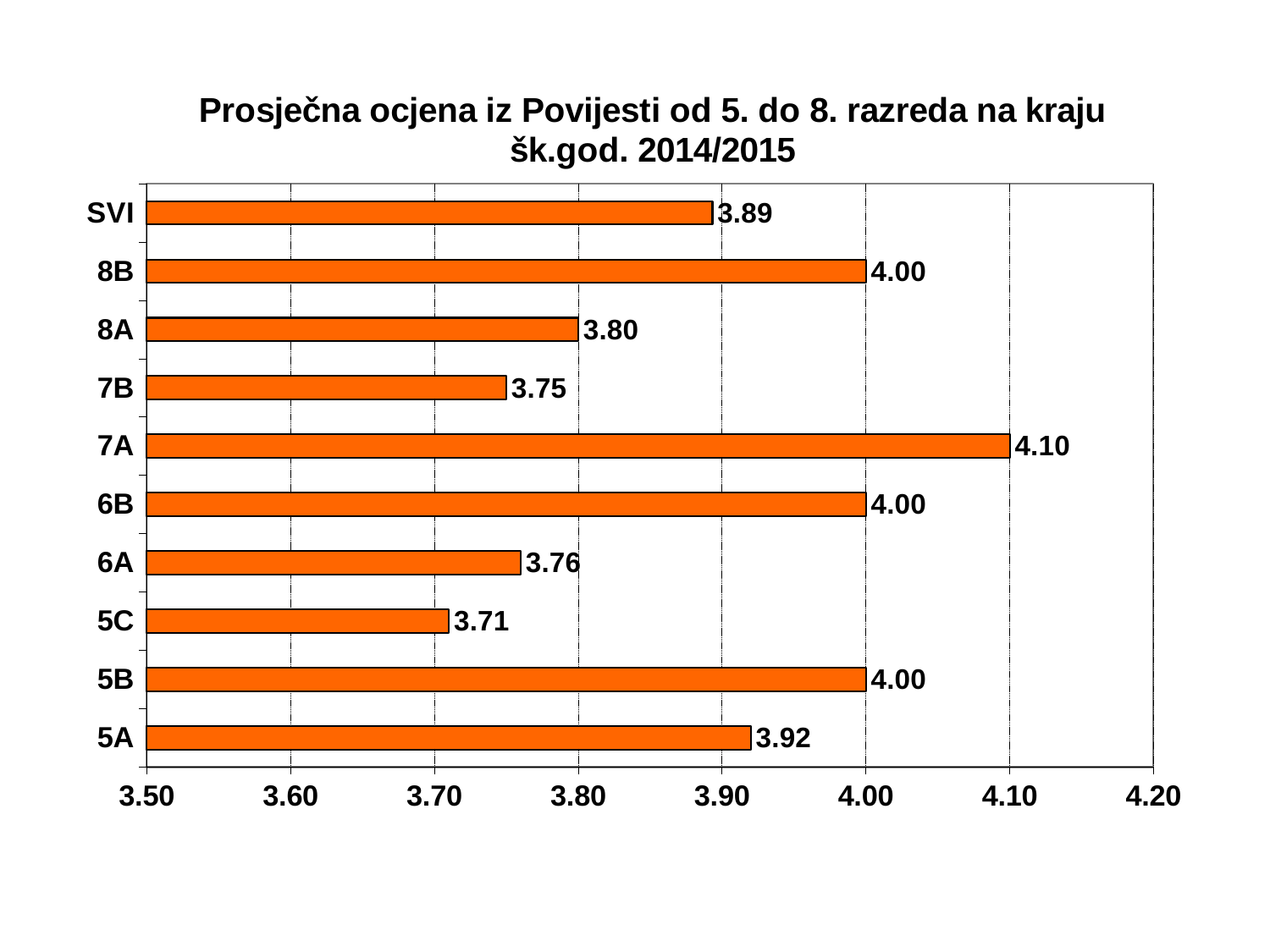
Which class has the highest average grade? 7A What kind of chart is shown on the slide? Bar chart Is the value for 6A greater or less than 3.80? less What is the value shown for SVI? 3.89 What is the average grade for class 7A? 4.10 How many categories are shown on the chart? 10 What is the average grade for class 5C? 3.71 How many classes have an average grade of exactly 4.00? 3 Which has a higher average grade, 8A or 8B? 8B What is the difference between the values for 5A and 5C? 0.21 Which class has the lowest average grade? 5C What is the difference between the values for 7A and 7B? 0.35